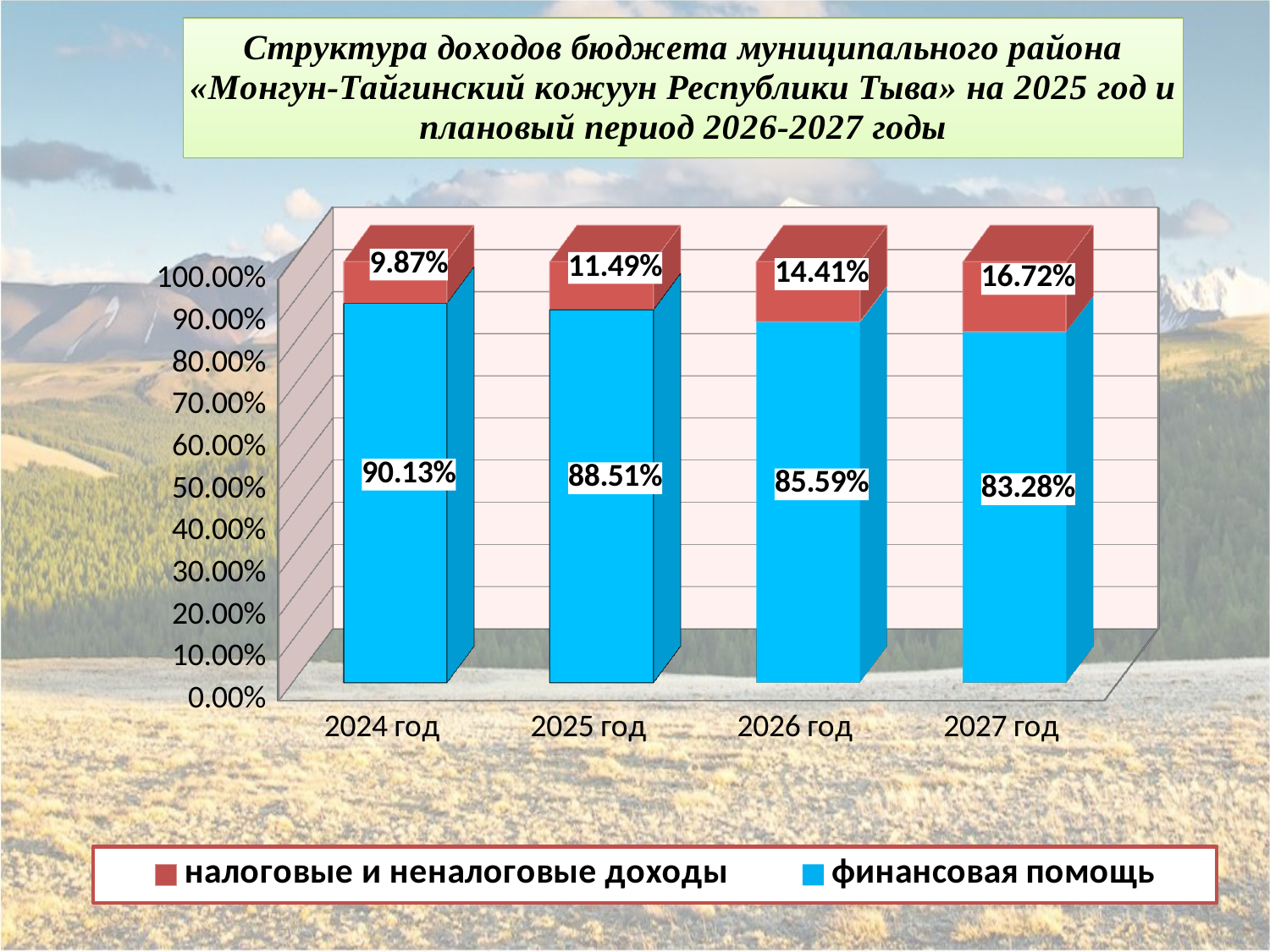
In which year is the share of «финансовая помощь» lowest? 2027 год What is the value for «налоговые и неналоговые доходы» in 2026 год? 14.41% What kind of chart is shown on the slide? Stacked bar chart Does the share of «налоговые и неналоговые доходы» rise or fall from 2024 год to 2027 год? Rise What is the value for «налоговые и неналоговые доходы» in 2024 год? 9.87% What is the value for «финансовая помощь» in 2027 год? 83.28% What is the value for «финансовая помощь» in 2025 год? 88.51% Which is larger: «финансовая помощь» in 2024 год or in 2026 год? 2024 год What is the difference between the «налоговые и неналоговые доходы» values for 2027 год and 2024 год? 6.85% In which year is the share of «налоговые и неналоговые доходы» highest? 2027 год How many series does the legend list? 2 How many years are shown on the x axis? 4